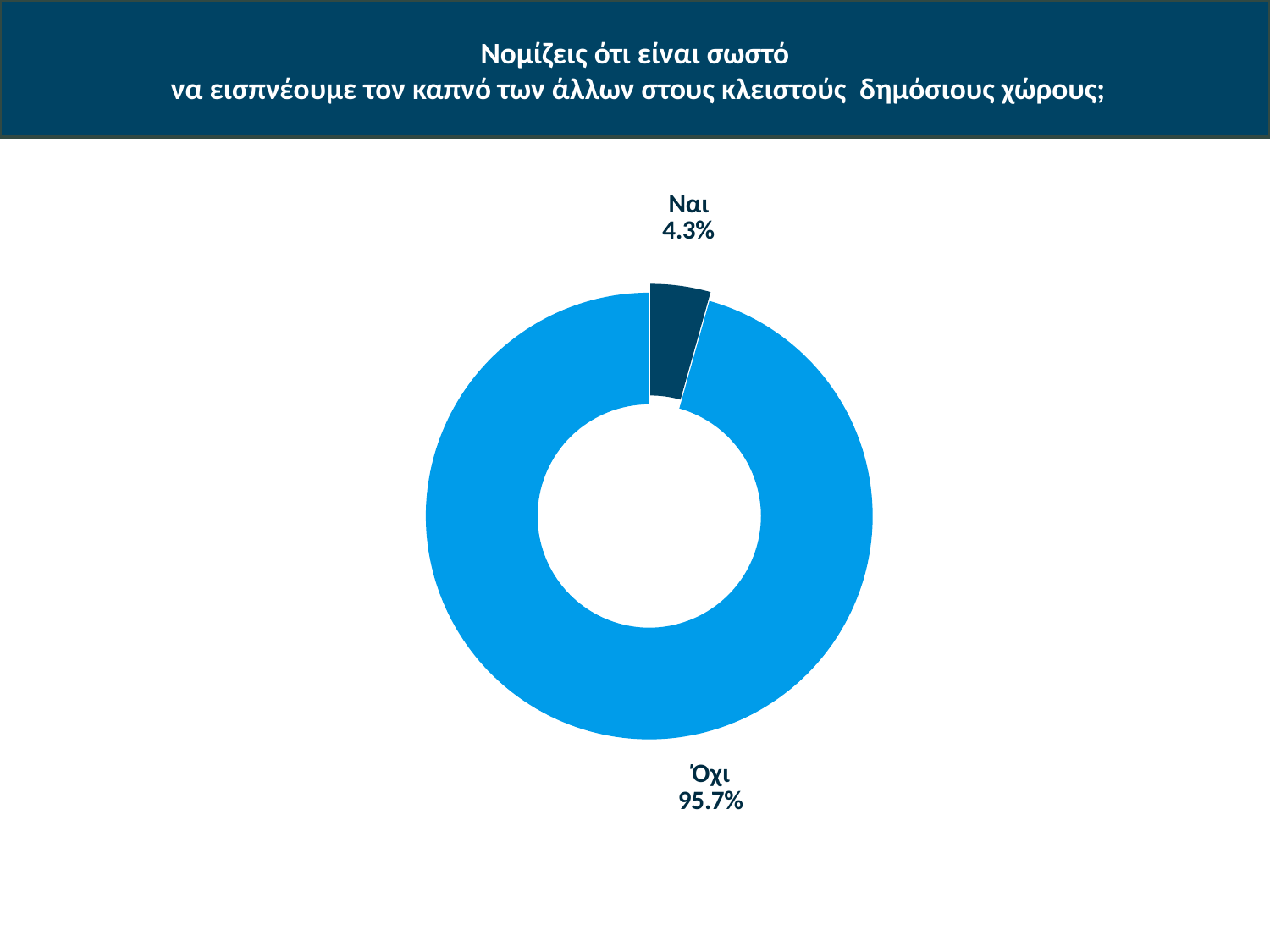
What is the total of the two percentages shown in the chart? 100% Which category has the smallest share of the chart? Ναι What colour is the Όχι slice? Light blue Which category has the largest share of the chart? Όχι What colour is the Ναι slice? Dark blue How many categories are shown in the chart? 2 What percentage of respondents answered Όχι? 95.7% What percentage of respondents answered Ναι? 4.3% Which is larger, the share for Ναι or the share for Όχι? Όχι What is the difference in percentage points between Όχι and Ναι? 91.4 What kind of chart is shown on the slide? Pie chart (doughnut) What share of the pie does the Ναι slice represent? 4.3%